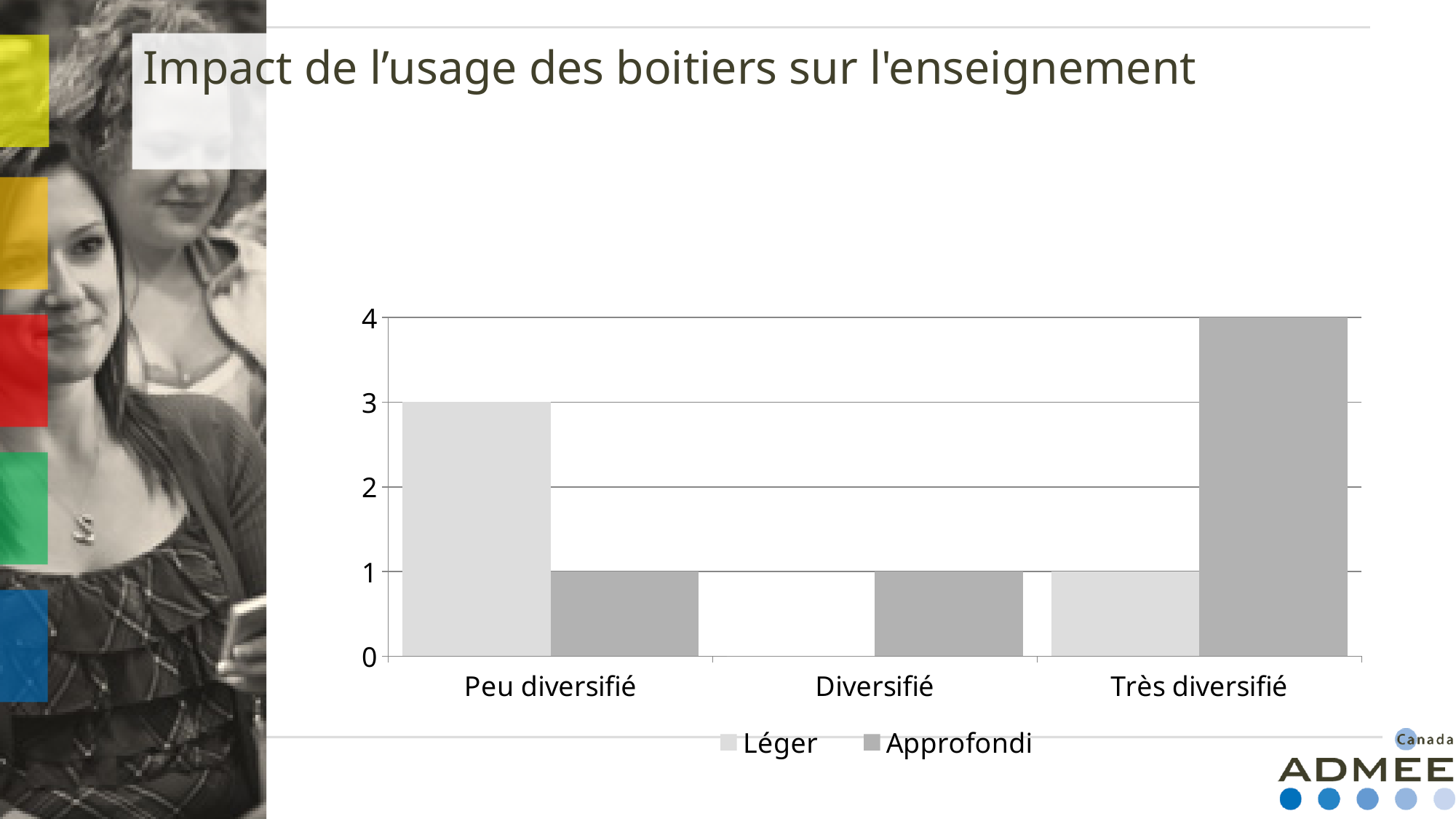
How many series does the legend list? 2 For Très diversifié, what is the difference between the Approfondi value and the Léger value? 3 What kind of chart is shown on the slide? Bar chart What is the value of the Léger series for Très diversifié? 1 Which category has the highest Approfondi value? Très diversifié How many categories are shown on the x axis? 3 What is the title of the slide? Impact de l’usage des boitiers sur l'enseignement What is the value of the Léger series for Peu diversifié? 3 Which category has the highest Léger value? Peu diversifié What is the value of the Approfondi series for Très diversifié? 4 What is the value of the Approfondi series for Peu diversifié? 1 For Peu diversifié, which series has the larger value, Léger or Approfondi? Léger